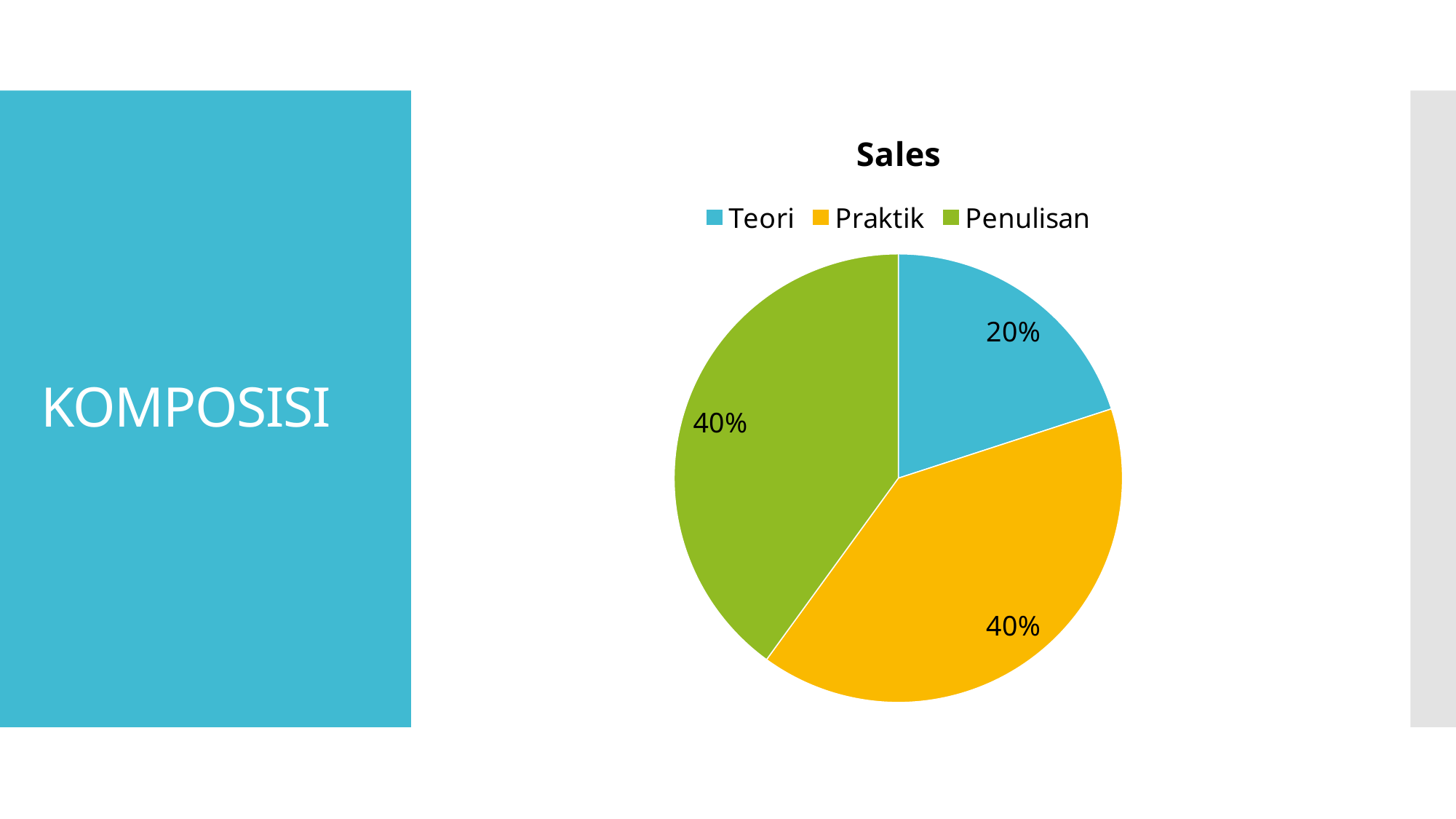
Which category has the smallest slice of the pie? Teori What is the title of the chart? Sales What share of the pie does Penulisan have? 40% What share of the pie does Praktik have? 40% What is the difference between the Penulisan share and the Teori share? 20% What is the combined share of Praktik and Penulisan? 80% What colour is the Penulisan slice? green What share of the pie does Teori have? 20% Which is larger, the slice for Praktik or the slice for Teori? Praktik How many categories does the legend list? 3 What type of chart is shown on the slide? pie chart